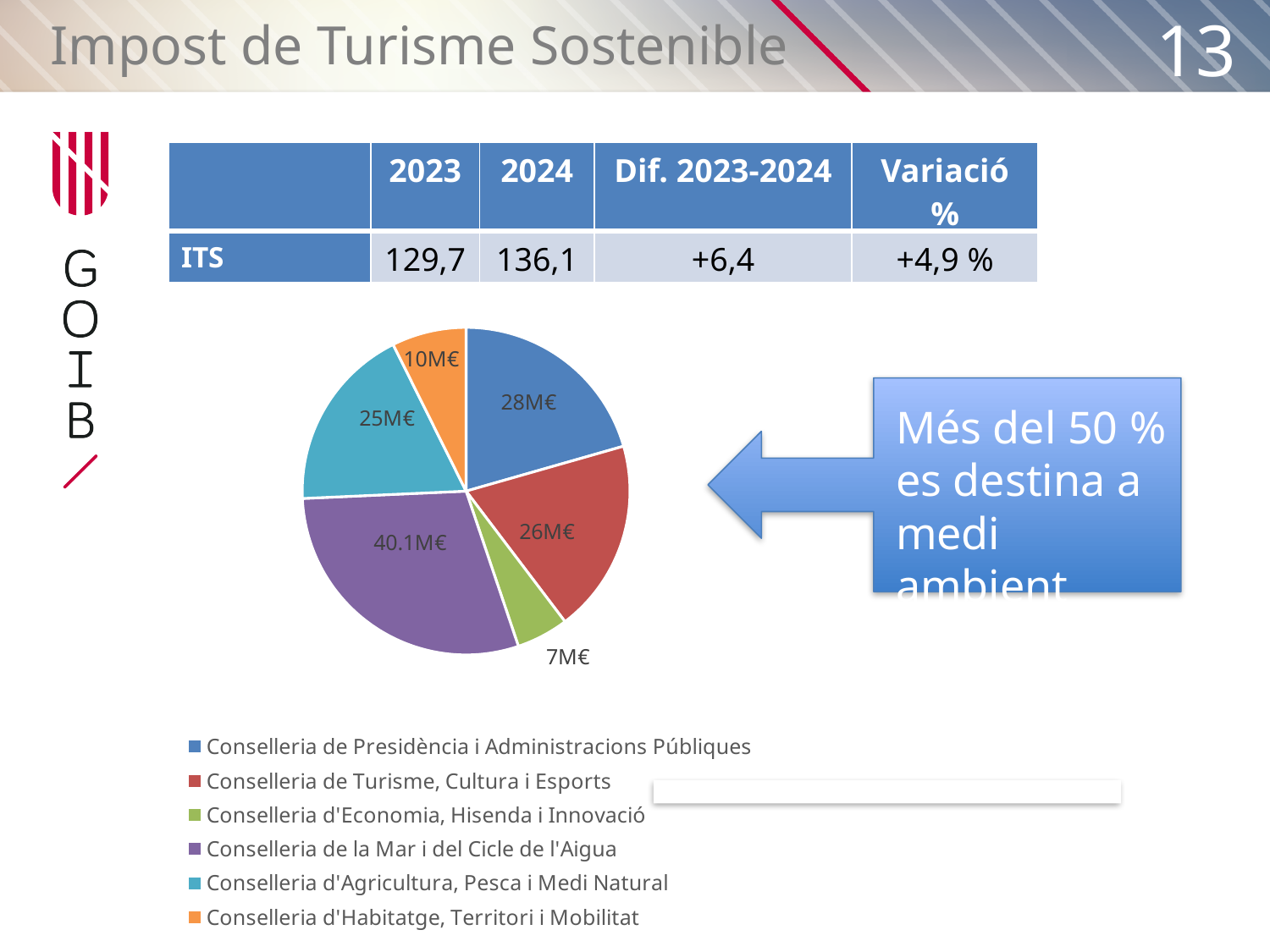
What is the total of all the values shown in the pie chart? 136.1M€ What type of chart is shown on the slide? Pie chart What value is shown for Conselleria de Presidència i Administracions Públiques in the pie chart? 28M€ Which is larger in the pie chart: Conselleria de Presidència i Administracions Públiques or Conselleria d'Agricultura, Pesca i Medi Natural? Conselleria de Presidència i Administracions Públiques What is the difference between the values for Conselleria de la Mar i del Cicle de l'Aigua and Conselleria de Turisme, Cultura i Esports? 14.1M€ What value is shown for Conselleria de la Mar i del Cicle de l'Aigua in the pie chart? 40.1M€ What value is shown for Conselleria d'Agricultura, Pesca i Medi Natural in the pie chart? 25M€ What colour is the slice for Conselleria de Turisme, Cultura i Esports? Red Which conselleria has the smallest slice in the pie chart? Conselleria d'Economia, Hisenda i Innovació Which conselleria has the largest slice in the pie chart? Conselleria de la Mar i del Cicle de l'Aigua How many slices does the pie chart have? 6 What value is shown for Conselleria d'Habitatge, Territori i Mobilitat in the pie chart? 10M€